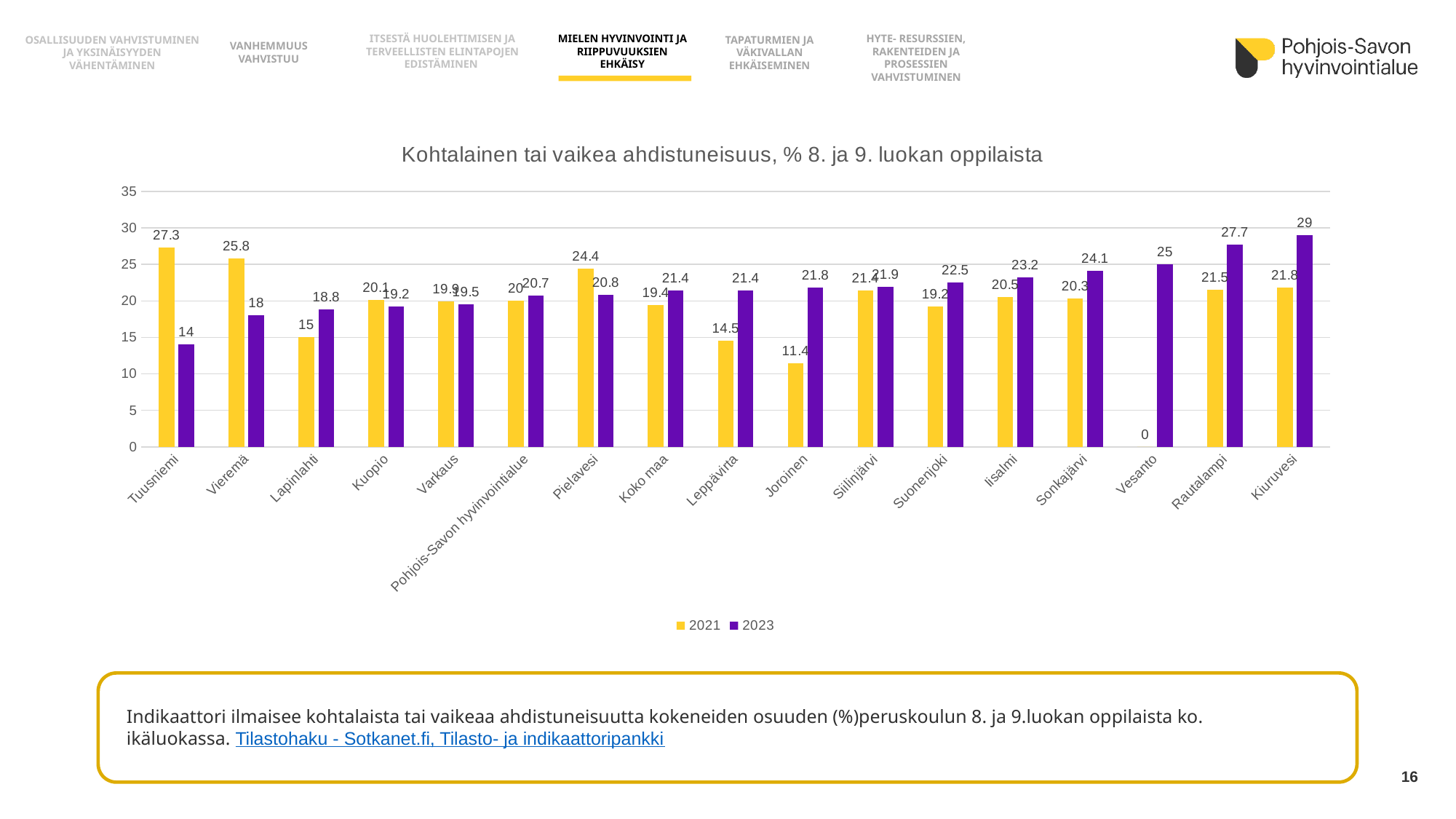
Which category has the highest 2023 value? Kiuruvesi How many categories are shown on the x axis? 17 What is the 2021 value for Tuusniemi? 27.3 Which category has the lowest 2023 value? Tuusniemi What is the 2023 value for Kiuruvesi? 29 What type of chart is shown on the slide? Bar chart What is the 2023 value for Vesanto? 25 What is the difference between the 2021 and 2023 values for Tuusniemi? 13.3 Which is larger for Leppävirta, the 2021 value or the 2023 value? 2023 Which category has the highest 2021 value? Tuusniemi What is the 2021 value for Joroinen? 11.4 How many series does the legend list? 2